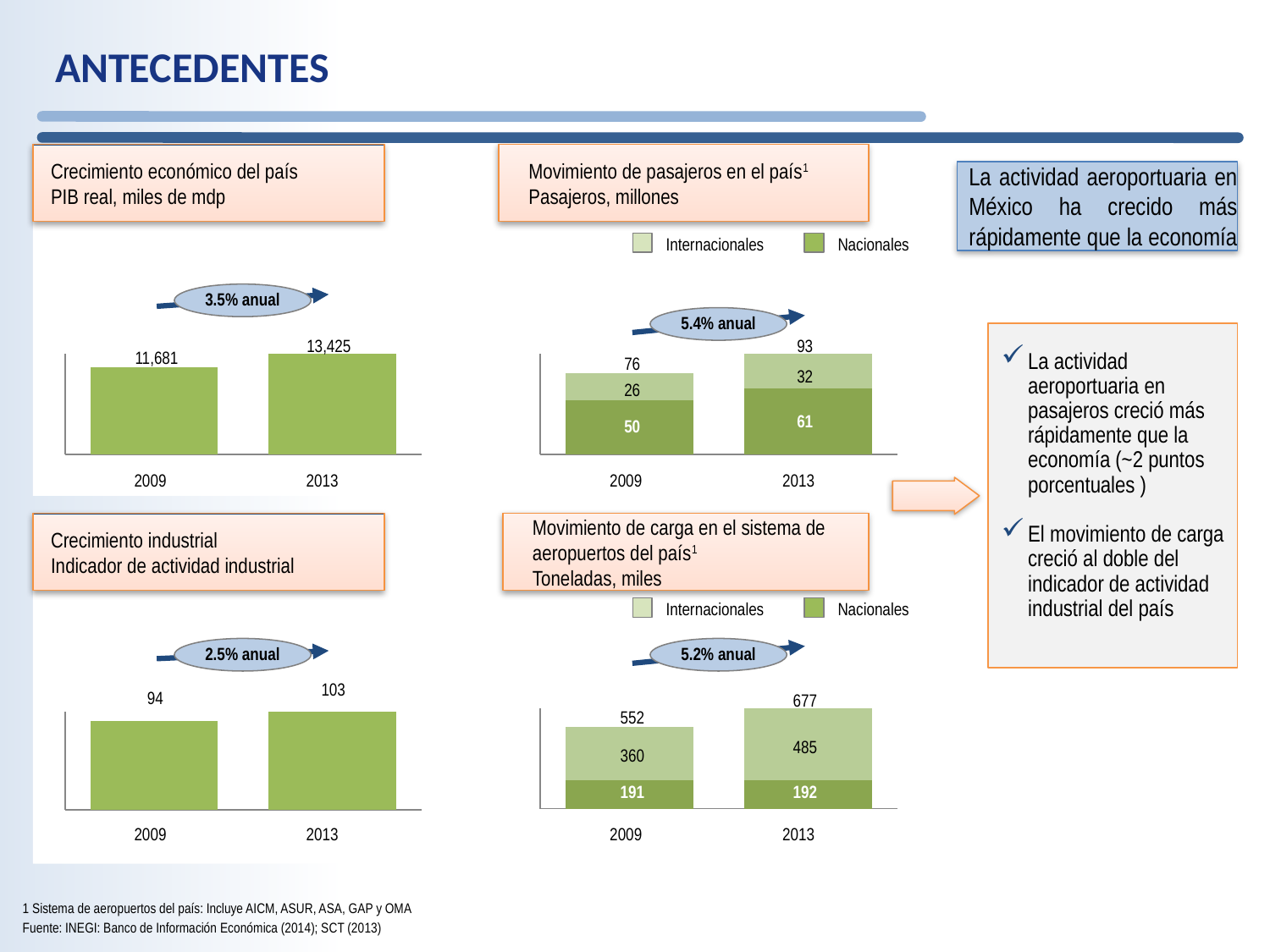
In the 'Crecimiento económico del país' chart, what is the value for 2013? 13,425 In the 'Movimiento de pasajeros en el país' chart, what is the total for the 2009 bar? 76 In the 'Movimiento de carga en el sistema de aeropuertos del país' chart, what is the difference between the Internacionales values for 2013 and 2009? 125 In the 'Movimiento de carga en el sistema de aeropuertos del país' chart, what is the Internacionales value for 2013? 485 In the 'Crecimiento económico del país' chart, what is the difference between the 2013 and 2009 values? 1,744 What kind of chart is the 'Movimiento de carga en el sistema de aeropuertos del país' chart? stacked bar chart How many categories are shown on the x axis of the 'Crecimiento económico del país' chart? 2 In the 'Movimiento de pasajeros en el país' chart, what is the Nacionales value for 2013? 61 In the 'Movimiento de carga en el sistema de aeropuertos del país' chart, which is larger in 2009: Internacionales or Nacionales? Internacionales In the 'Crecimiento industrial' chart, what is the value for 2009? 94 In the 'Crecimiento industrial' chart, do the values rise or fall from 2009 to 2013? rise How many series does the legend of the 'Movimiento de pasajeros en el país' chart list? 2